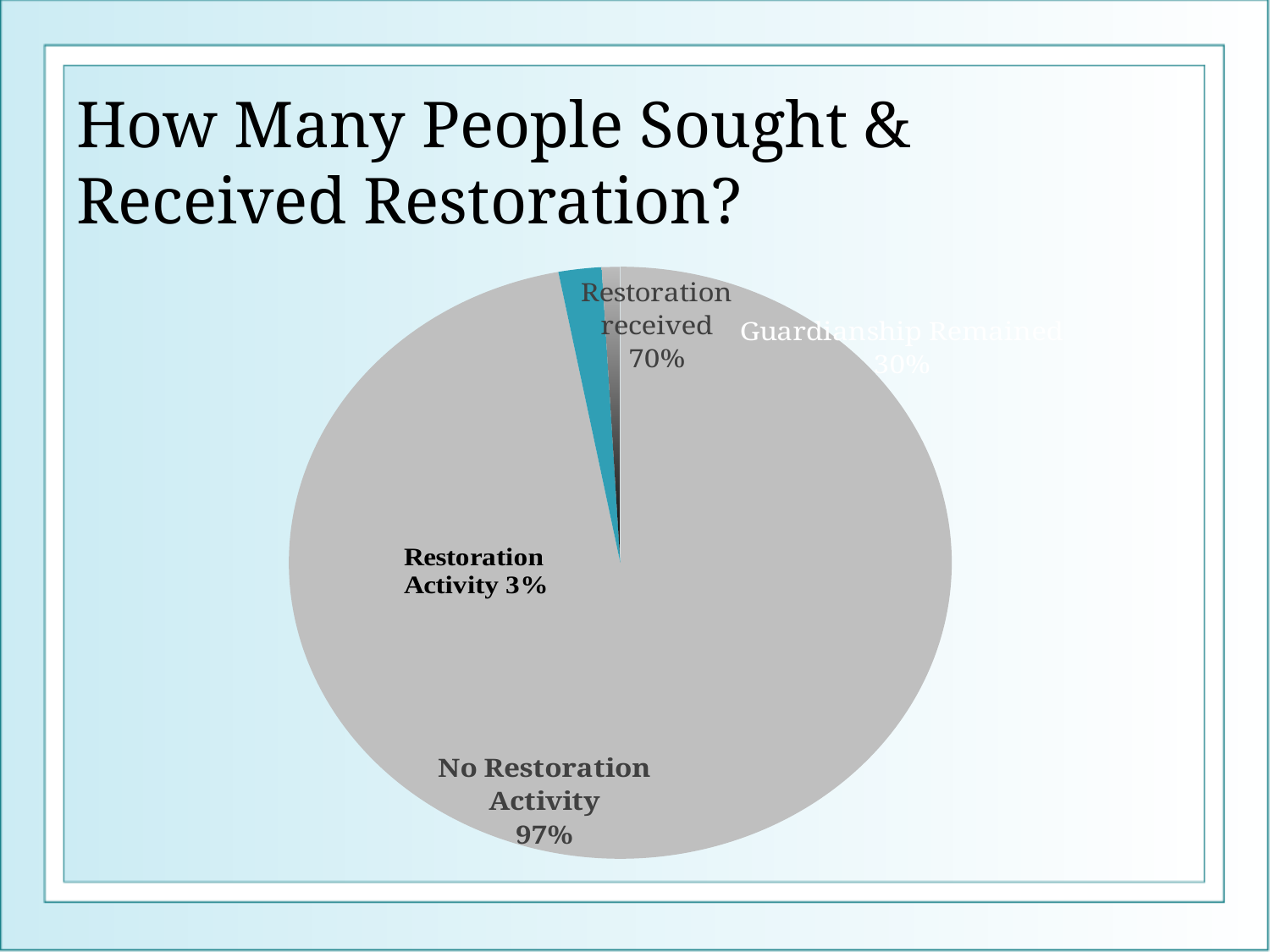
What percentage is shown for No Restoration Activity? 97% What kind of chart is shown on the slide? Pie chart What is the difference in percentage points between No Restoration Activity (97%) and Restoration Activity (3%)? 94 percentage points What percentage is shown for Guardianship Remained? 30% What colour is the Restoration Activity slice of the pie? Teal (blue) What percentage is shown for Restoration received? 70% Which category has the largest share of the pie? No Restoration Activity Which labelled category has the smallest percentage on the chart? Restoration Activity What percentage is shown for Restoration Activity? 3% What is the title of the slide containing the pie chart? How Many People Sought & Received Restoration? What is the difference in percentage points between Restoration received (70%) and Guardianship Remained (30%)? 40 percentage points Which is larger, No Restoration Activity or Restoration Activity? No Restoration Activity